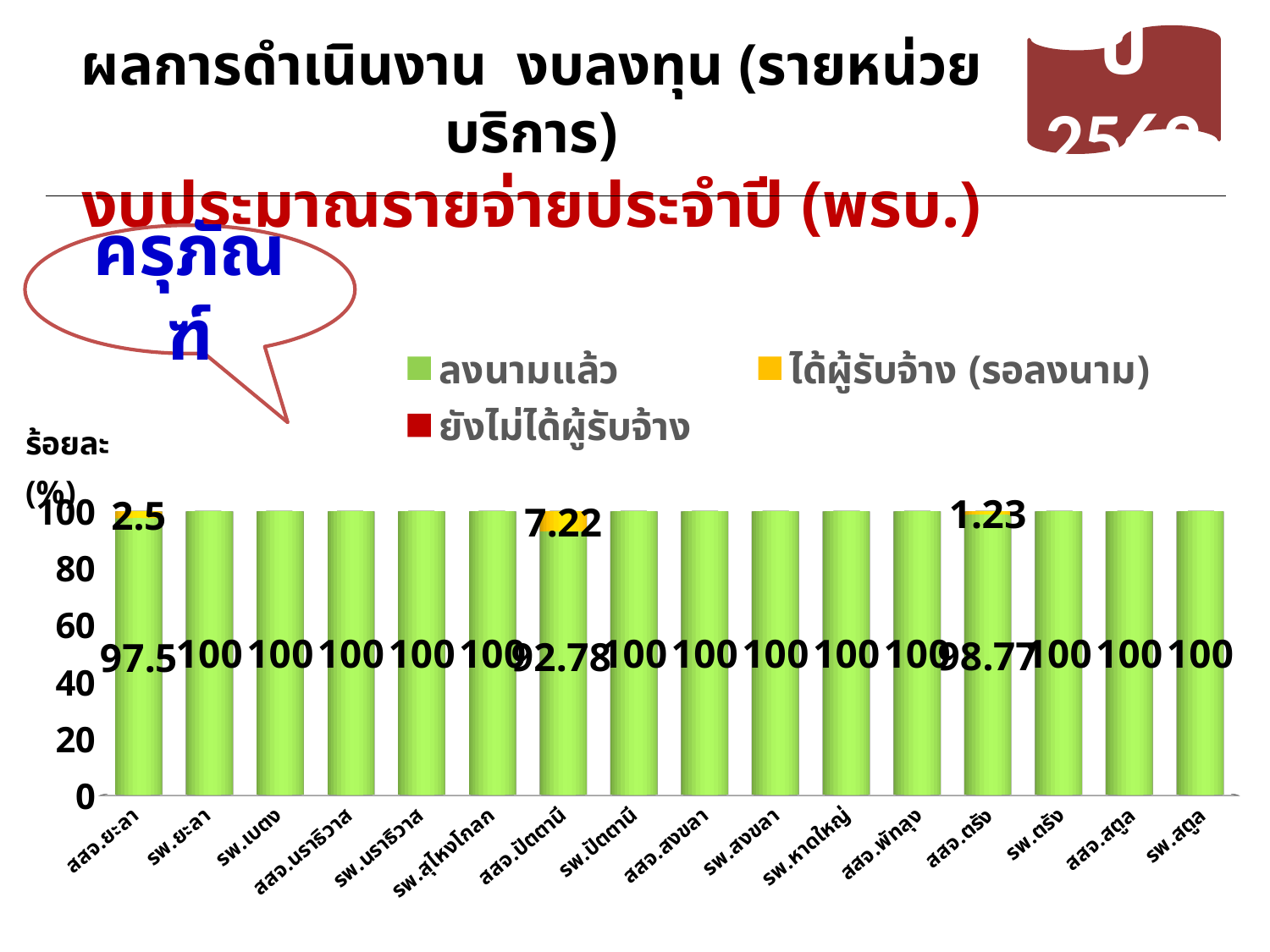
How many categories (units) are shown along the x axis of the chart? 16 What type of chart is shown on the slide? bar chart Which legend entry is shown in yellow? ได้ผู้รับจ้าง (รอลงนาม) Which category has the lowest value for ลงนามแล้ว? สสจ.ปัตตานี What is the value of ลงนามแล้ว for สสจ.ยะลา? 97.5 How many series does the chart legend list? 3 What is the value of ได้ผู้รับจ้าง (รอลงนาม) for สสจ.ปัตตานี? 7.22 What is the total of the stacked bar for สสจ.ปัตตานี? 100 Which is larger, the ลงนามแล้ว value for สสจ.ตรัง or for สสจ.ปัตตานี? สสจ.ตรัง What is the difference between the ลงนามแล้ว values for รพ.ยะลา and สสจ.ยะลา? 2.5 What is the value of ลงนามแล้ว for สสจ.ตรัง? 98.77 What is the value of ได้ผู้รับจ้าง (รอลงนาม) for สสจ.ตรัง? 1.23